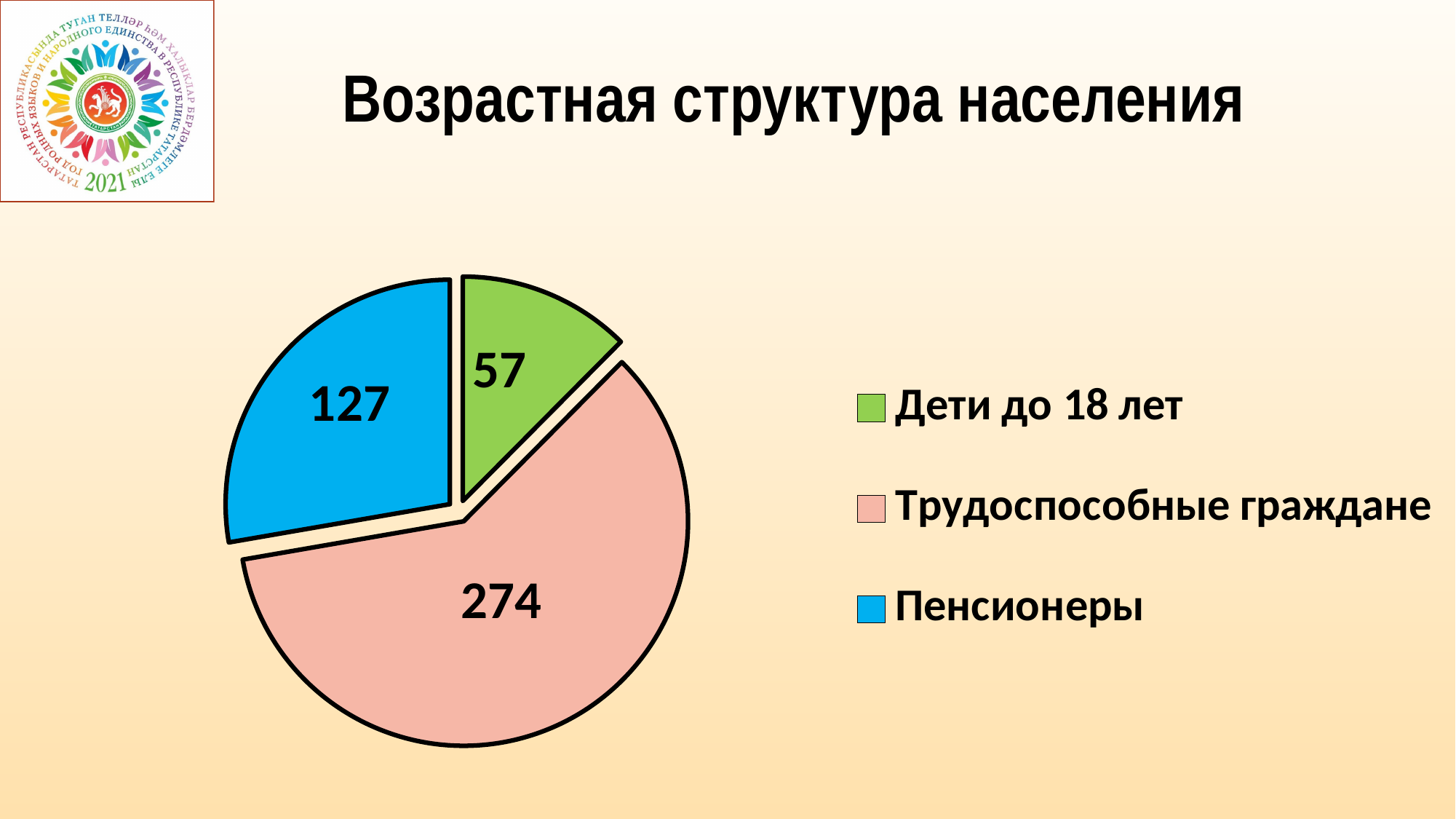
What colour is the slice for Пенсионеры? blue What is the difference between the values for Пенсионеры and Дети до 18 лет? 70 Which category has the smallest slice of the pie? Дети до 18 лет What is the title of the chart? Возрастная структура населения What type of chart is shown on the slide? pie chart What is the value for Дети до 18 лет? 57 What is the difference between the values for Трудоспособные граждане and Пенсионеры? 147 How many categories does the pie chart have? 3 What is the value for Пенсионеры? 127 Which is larger, the value for Пенсионеры or the value for Дети до 18 лет? Пенсионеры What is the value for Трудоспособные граждане? 274 Which category has the largest slice of the pie? Трудоспособные граждане